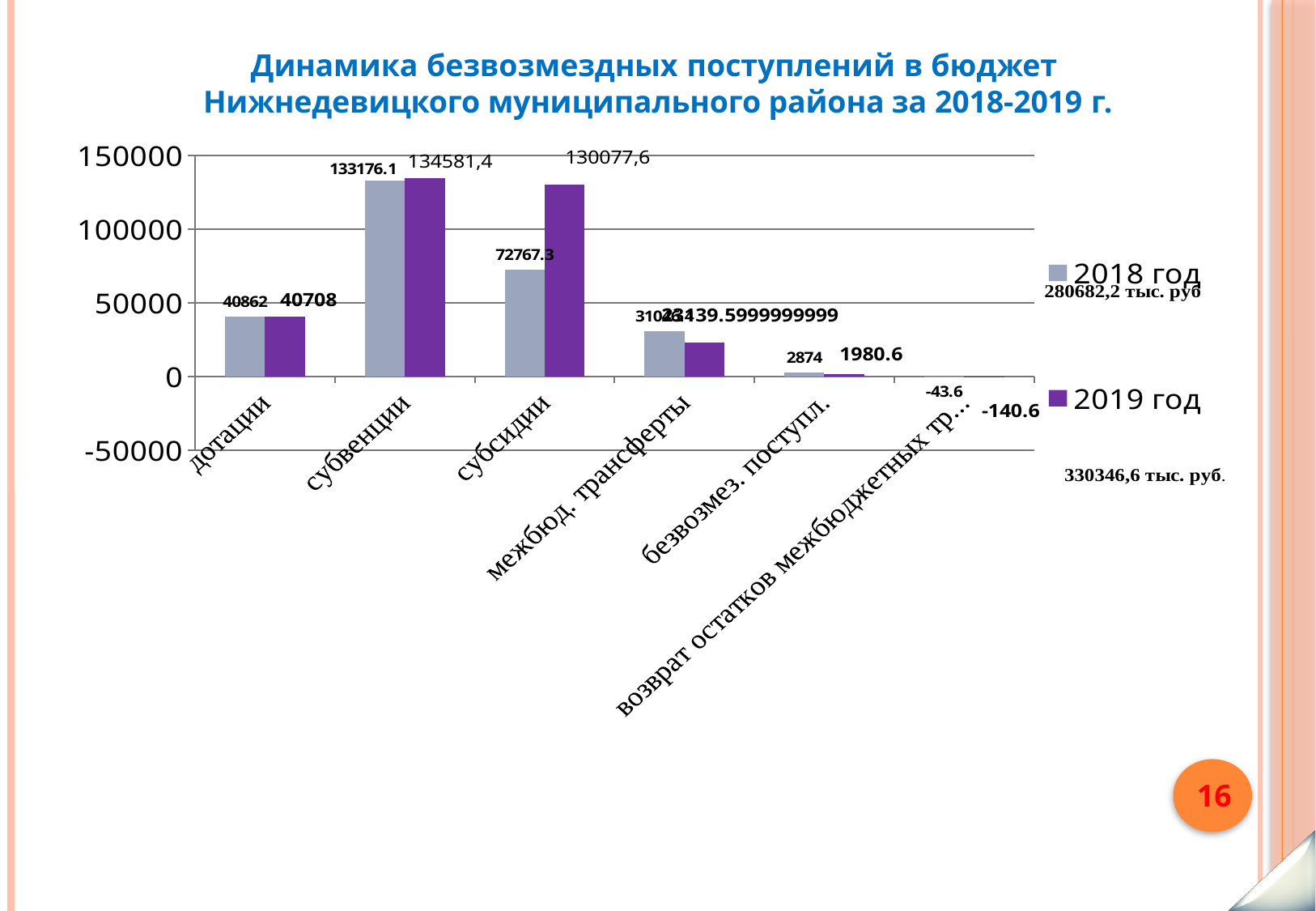
Which category has the highest value in the 2019 год series? субвенции Which category has the lowest value in the 2018 год series? возврат остатков межбюджетных тр... For субсидии, which year has the larger value, 2018 год or 2019 год? 2019 год What is the value for безвозмез. поступл. in 2019 год? 1980.6 What is the value for субвенции in 2019 год? 134581,4 What kind of chart is shown on the slide? bar chart Is the 2018 год value for межбюд. трансферты greater or less than 50000? less How many series does the legend list? 2 How many categories are shown on the x axis? 6 What is the value for дотации in 2018 год? 40862 What is the value for субсидии in 2018 год? 72767.3 What is the difference between the 2018 год and 2019 год values for дотации? 154